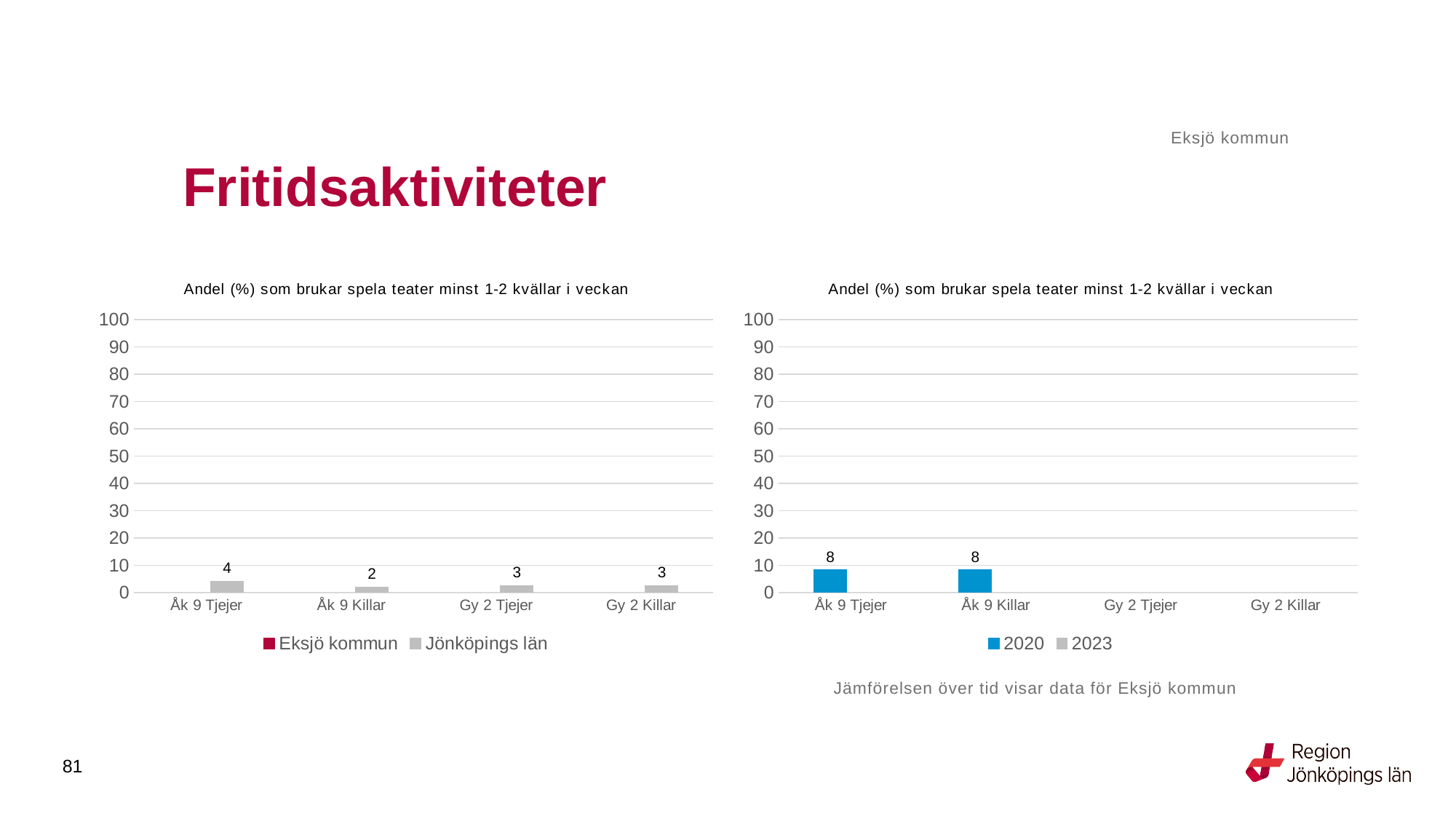
In the right chart, what is the 2020 value for Åk 9 Tjejer? 8 In the left chart, what is the Jönköpings län value for Gy 2 Tjejer? 3 In the left chart, which is larger for Jönköpings län: Åk 9 Tjejer or Gy 2 Killar? Åk 9 Tjejer In the left chart, what is the Jönköpings län value for Åk 9 Killar? 2 How many series does the legend of the right chart list? 2 In the left chart, which category has the lowest Jönköpings län value? Åk 9 Killar What type of chart is the right chart? Bar chart How many categories are shown on the x axis of the left chart? 4 In the left chart, which category has the highest Jönköpings län value? Åk 9 Tjejer In the left chart, what is the difference between the Jönköpings län values for Åk 9 Tjejer and Åk 9 Killar? 2 In the left chart, what is the Jönköpings län value for Åk 9 Tjejer? 4 In the right chart, what is the 2020 value for Åk 9 Killar? 8